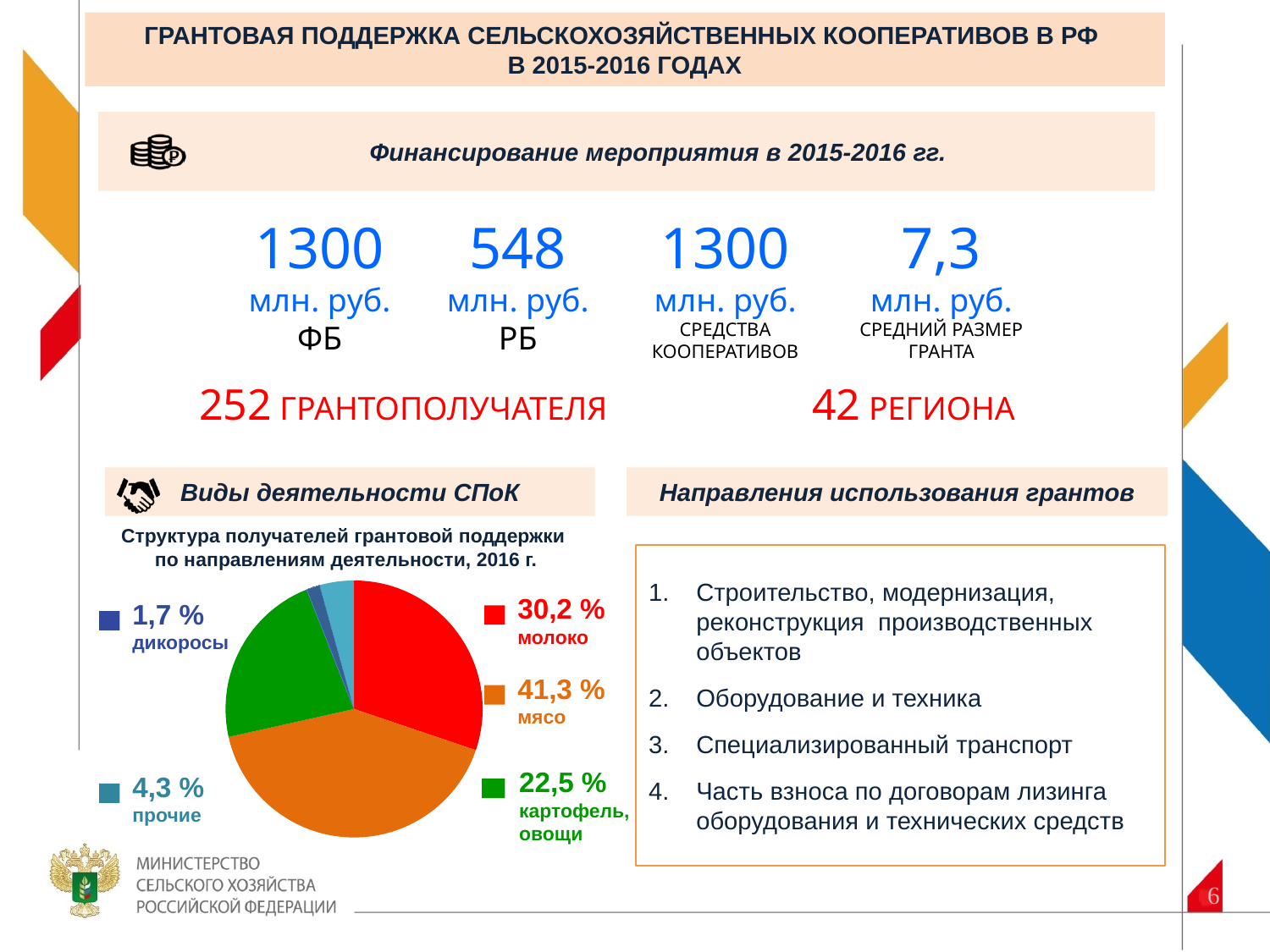
What share of the pie chart does "картофель, овощи" have? 22,5 % What type of chart is shown on the slide? pie chart Which category has the largest slice in the pie chart? мясо What is the title of the pie chart? Структура получателей грантовой поддержки по направлениям деятельности, 2016 г. Which is larger in the pie chart: "прочие" or "дикоросы"? прочие What share of the pie chart does "прочие" have? 4,3 % What is the difference in percentage points between "мясо" and "молоко" in the pie chart? 11,1 % Which category has the smallest slice in the pie chart? дикоросы How many slices does the pie chart have? 5 What share of the pie chart does "мясо" have? 41,3 % What share of the pie chart does "молоко" have? 30,2 % What share of the pie chart does "дикоросы" have? 1,7 %